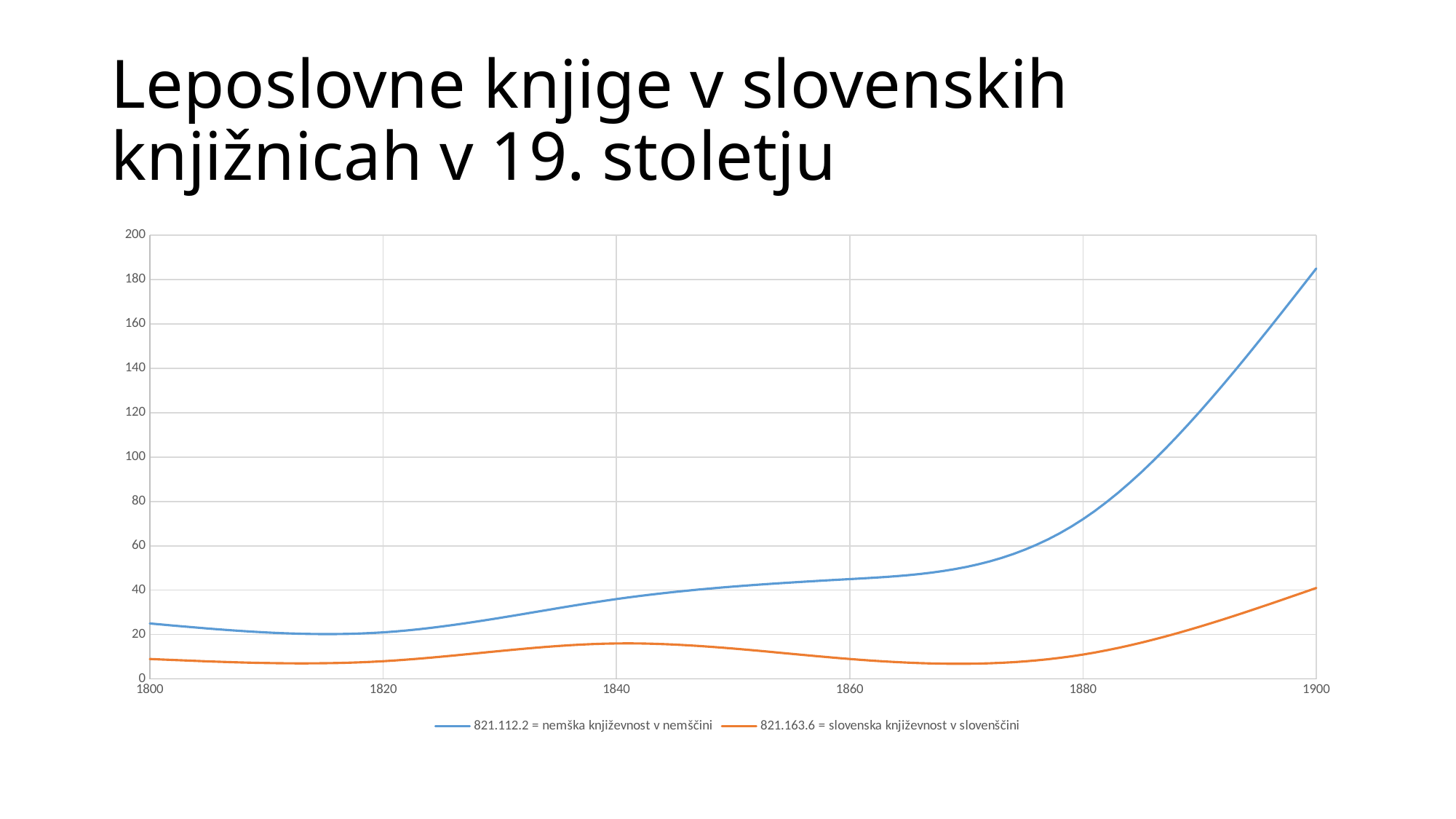
Which series is drawn in orange? 821.163.6 = slovenska književnost v slovenščini Is the value for 821.163.6 = slovenska književnost v slovenščini at 1900 greater or less than 60? less What kind of chart is shown on the slide? line chart At 1900, which series has the larger value, 821.112.2 = nemška književnost v nemščini or 821.163.6 = slovenska književnost v slovenščini? 821.112.2 = nemška književnost v nemščini At which labelled year does 821.112.2 = nemška književnost v nemščini reach its highest value? 1900 Is the value for 821.112.2 = nemška književnost v nemščini at 1900 greater or less than 160? greater How many series does the legend list? 2 What is the title of the slide containing the chart? Leposlovne knjige v slovenskih knjižnicah v 19. stoletju Is the value for 821.112.2 = nemška književnost v nemščini at 1860 greater or less than 40? greater Does the value for 821.112.2 = nemška književnost v nemščini rise or fall between 1860 and 1900? rise